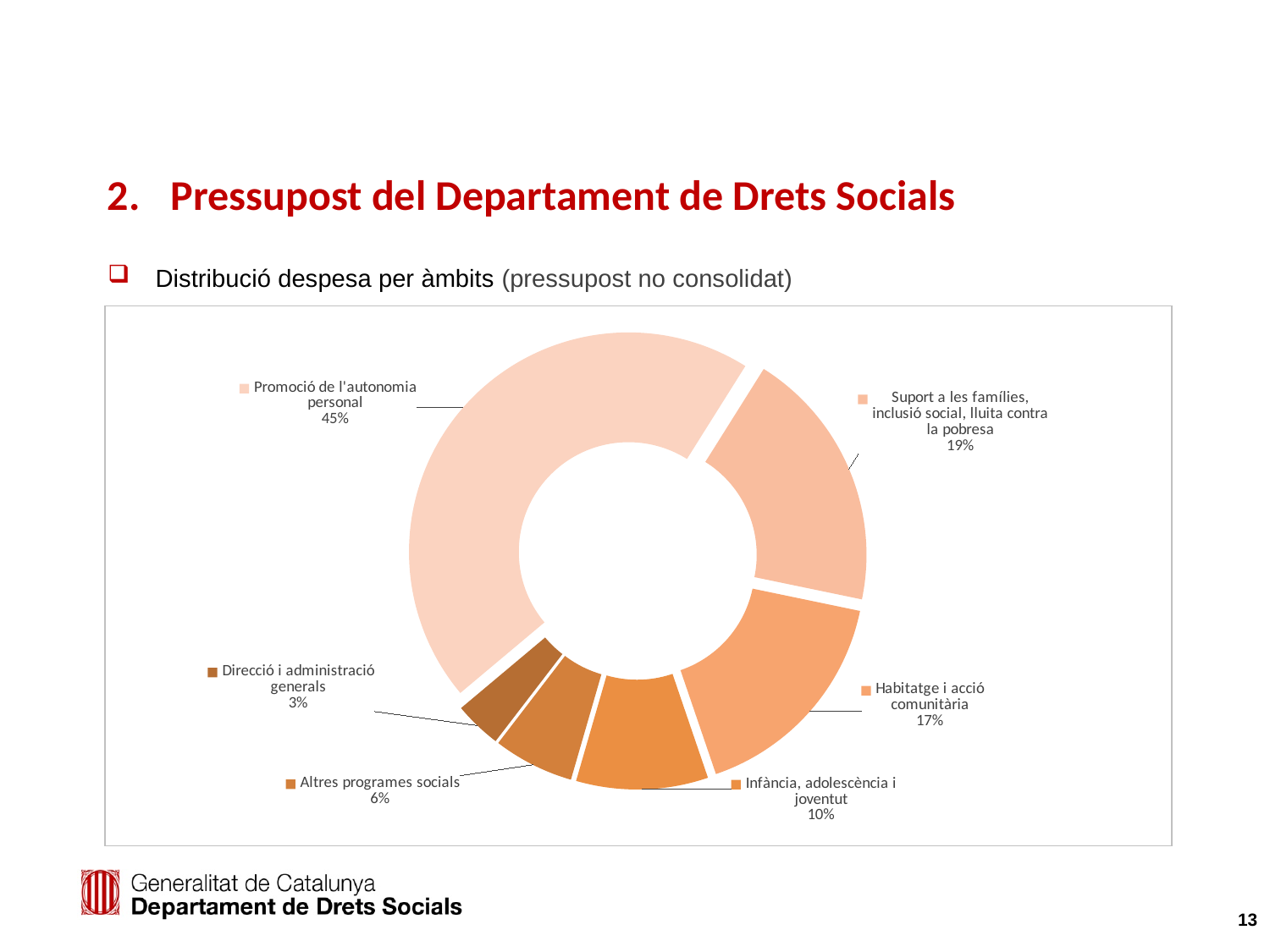
What is the combined share of Altres programes socials and Direcció i administració generals? 9% What share of the spending goes to Infància, adolescència i joventut? 10% Which area has the largest share of the spending? Promoció de l'autonomia personal Which has a larger share: Habitatge i acció comunitària or Infància, adolescència i joventut? Habitatge i acció comunitària How many areas are shown in the chart? 6 Which area has the smallest share of the spending? Direcció i administració generals What kind of chart is shown on the slide? Doughnut (pie) chart What share of the spending goes to Suport a les famílies, inclusió social, lluita contra la pobresa? 19% What share of the spending goes to Promoció de l'autonomia personal? 45% What share of the spending goes to Direcció i administració generals? 3% What share of the spending goes to Habitatge i acció comunitària? 17% What is the difference in percentage points between Promoció de l'autonomia personal and Suport a les famílies, inclusió social, lluita contra la pobresa? 26 percentage points